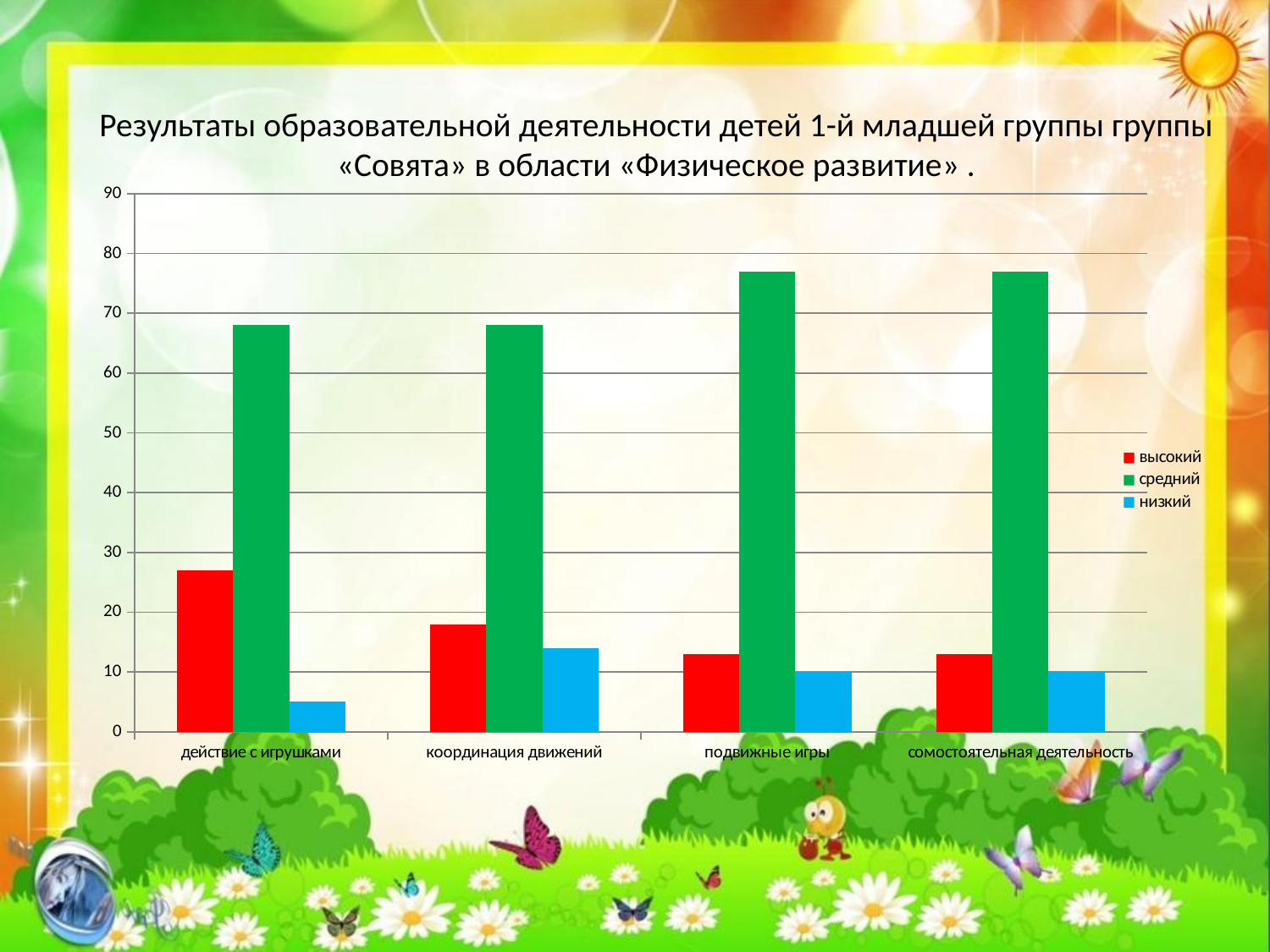
Which is larger for the высокий series: действие с игрушками or координация движений? действие с игрушками Which category has the highest value for the высокий series? действие с игрушками How many categories are shown along the x axis? 4 Is the средний value for подвижные игры greater or less than 70? greater What colour represents the средний series in the legend? green Which category has the lowest value for the низкий series? действие с игрушками Which series has the highest value for действие с игрушками? средний Is the низкий value for действие с игрушками greater or less than 10? less How many series does the legend list? 3 Which is larger for the низкий series: координация движений or подвижные игры? координация движений What kind of chart is shown on the slide? bar chart Is the высокий value for действие с игрушками greater or less than 20? greater